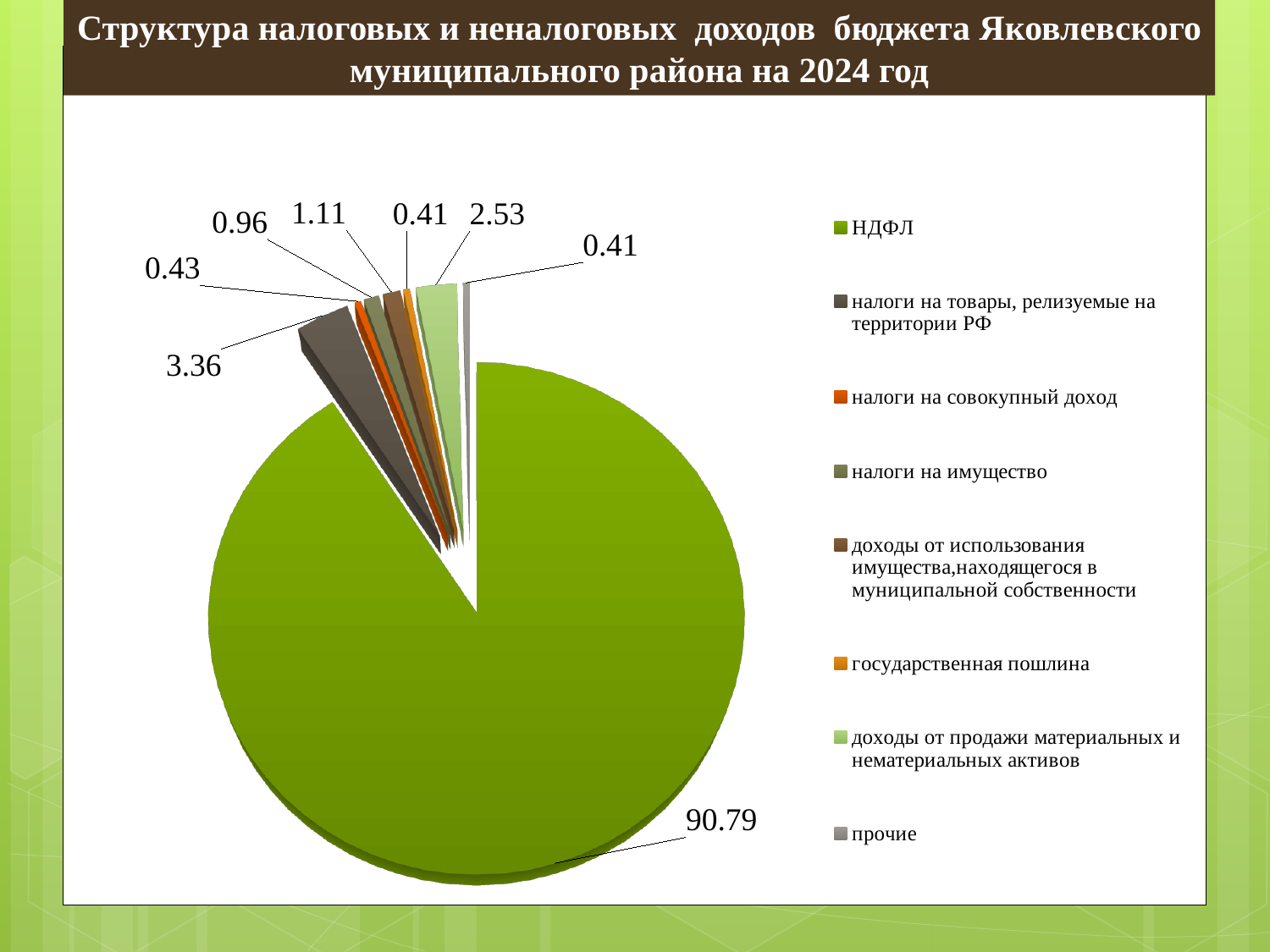
What is the value shown for доходы от продажи материальных и нематериальных активов? 2.53 Which is larger: налоги на товары, релизуемые на территории РФ or доходы от продажи материальных и нематериальных активов? налоги на товары, релизуемые на территории РФ What is the value shown for налоги на совокупный доход? 0.43 What is the value shown for налоги на товары, релизуемые на территории РФ? 3.36 What is the difference between the values for налоги на товары, релизуемые на территории РФ and налоги на имущество? 2.40 Which category has the largest slice of the pie? НДФЛ What is the value shown for доходы от использования имущества, находящегося в муниципальной собственности? 1.11 What kind of chart is shown on the slide? pie chart What is the value shown for НДФЛ? 90.79 What is the value shown for государственная пошлина? 0.41 How many categories does the legend list? 8 What is the value shown for налоги на имущество? 0.96